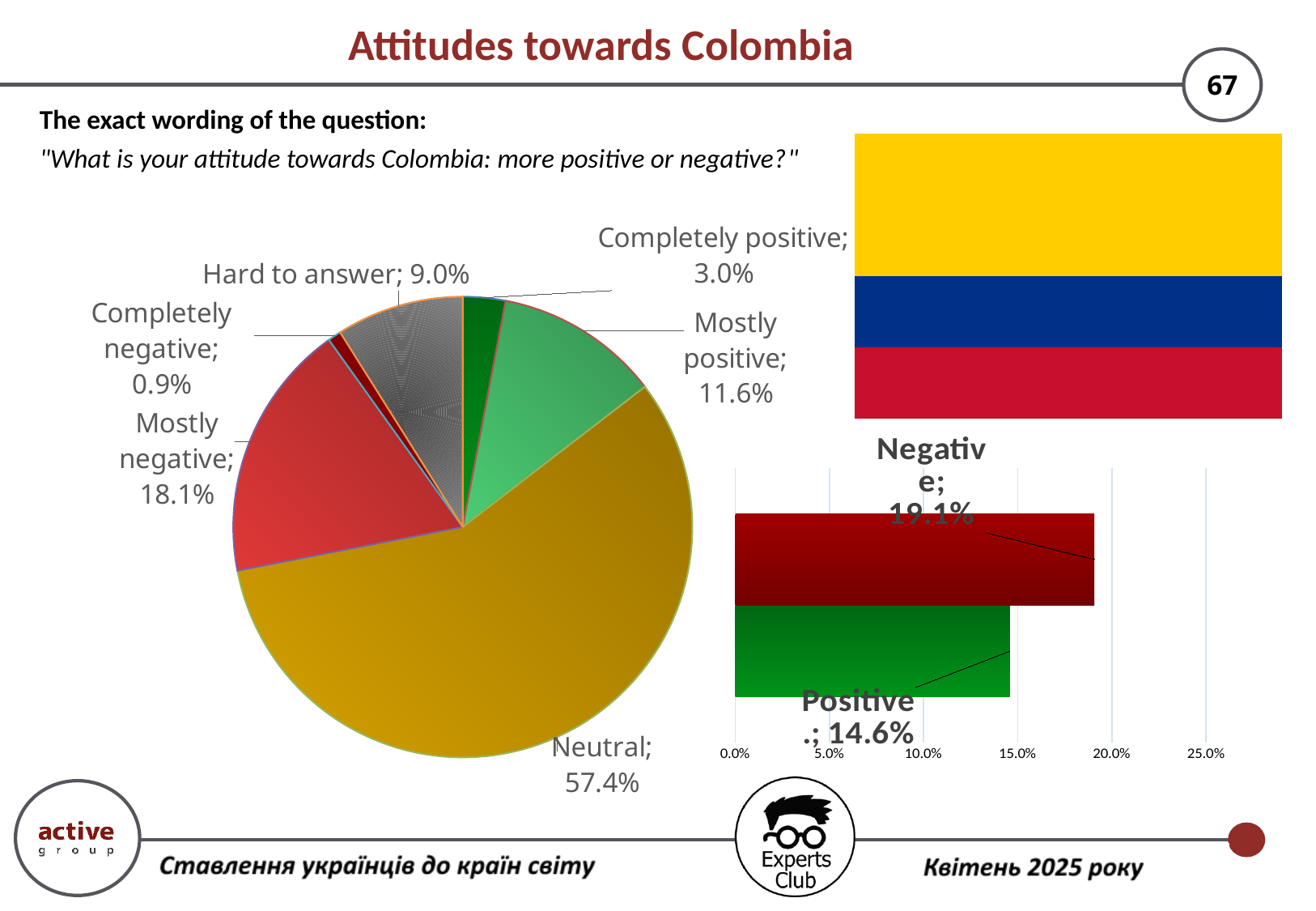
In the pie chart, which category has the largest share? Neutral In the pie chart, what is the difference between Mostly negative and Mostly positive? 6.5% In the bar chart on the right, which is larger, Negative or Positive? Negative In the bar chart on the right, what is the value for Positive? 14.6% In the pie chart, how many categories are shown? 6 What kind of chart is shown on the right side of the slide? Bar chart In the pie chart, what share of respondents answered Completely positive? 3.0% In the pie chart, what share of respondents answered Neutral? 57.4% In the pie chart, what share of respondents answered Mostly negative? 18.1% In the pie chart, what share of respondents answered Hard to answer? 9.0% In the bar chart on the right, what is the value for Negative? 19.1% In the pie chart, which category has the smallest share? Completely negative